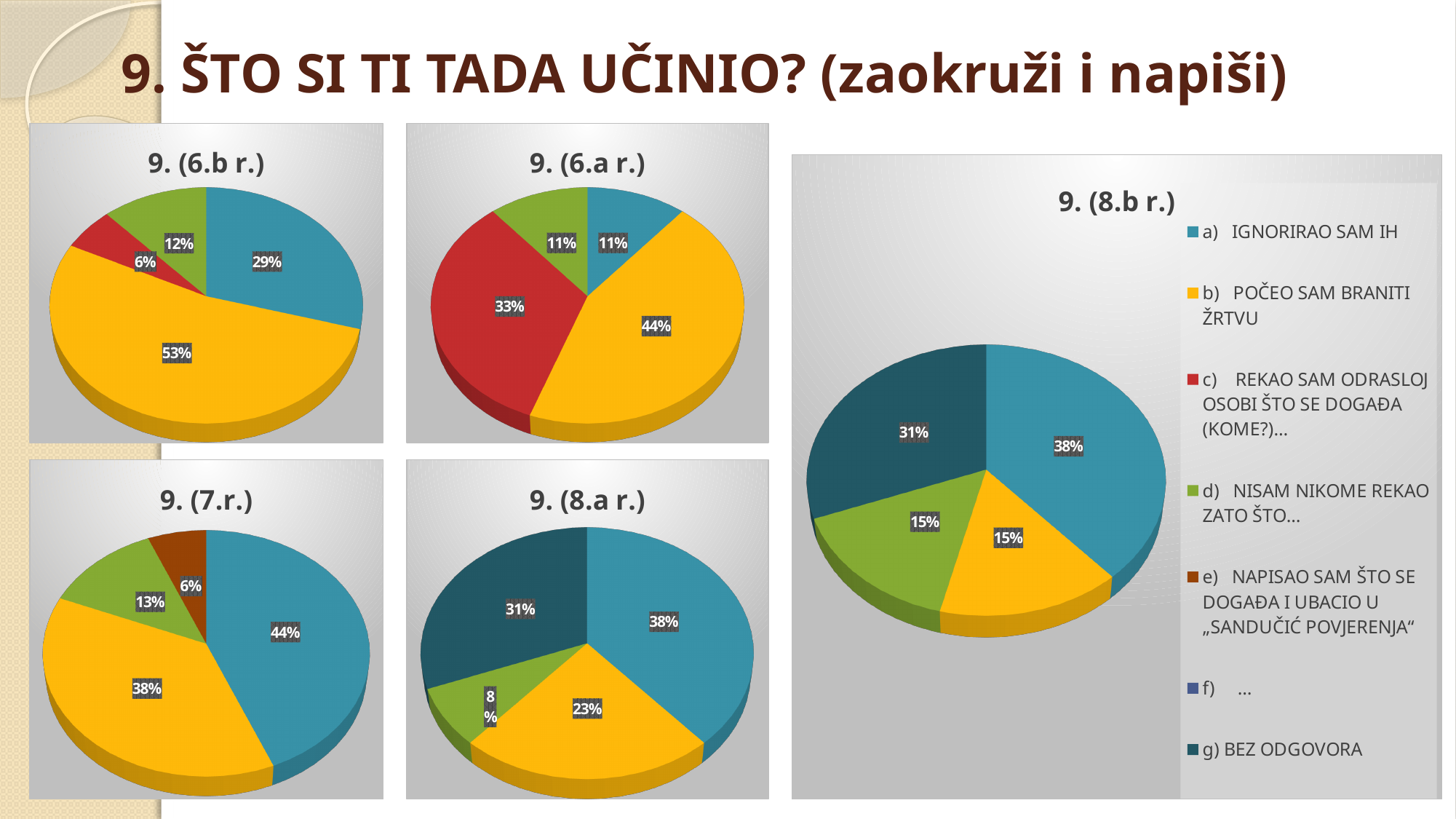
In the chart titled "9. (6.b r.)", what is the smallest slice's percentage? 6% In the chart titled "9. (6.a r.)", what percentage does the red slice show? 33% In the chart titled "9. (6.b r.)", what is the largest slice's percentage? 53% In the chart titled "9. (8.a r.)", what percentage does the yellow slice show? 23% In the chart titled "9. (7.r.)", what percentage does the brown slice show? 6% How many slices does the chart titled "9. (8.a r.)" have? 4 In the chart titled "9. (6.a r.)", what is the difference between the yellow slice and the red slice? 11% In the chart titled "9. (8.b r.)", what percentage is shown for "g) BEZ ODGOVORA"? 31% In the chart titled "9. (7.r.)", which is larger, the blue slice or the yellow slice? the blue slice (44%) How many entries does the legend of the chart titled "9. (8.b r.)" list? 7 In the chart titled "9. (8.b r.)", what percentage is shown for "a) IGNORIRAO SAM IH"? 38% What type of chart is the chart titled "9. (6.a r.)"? pie chart